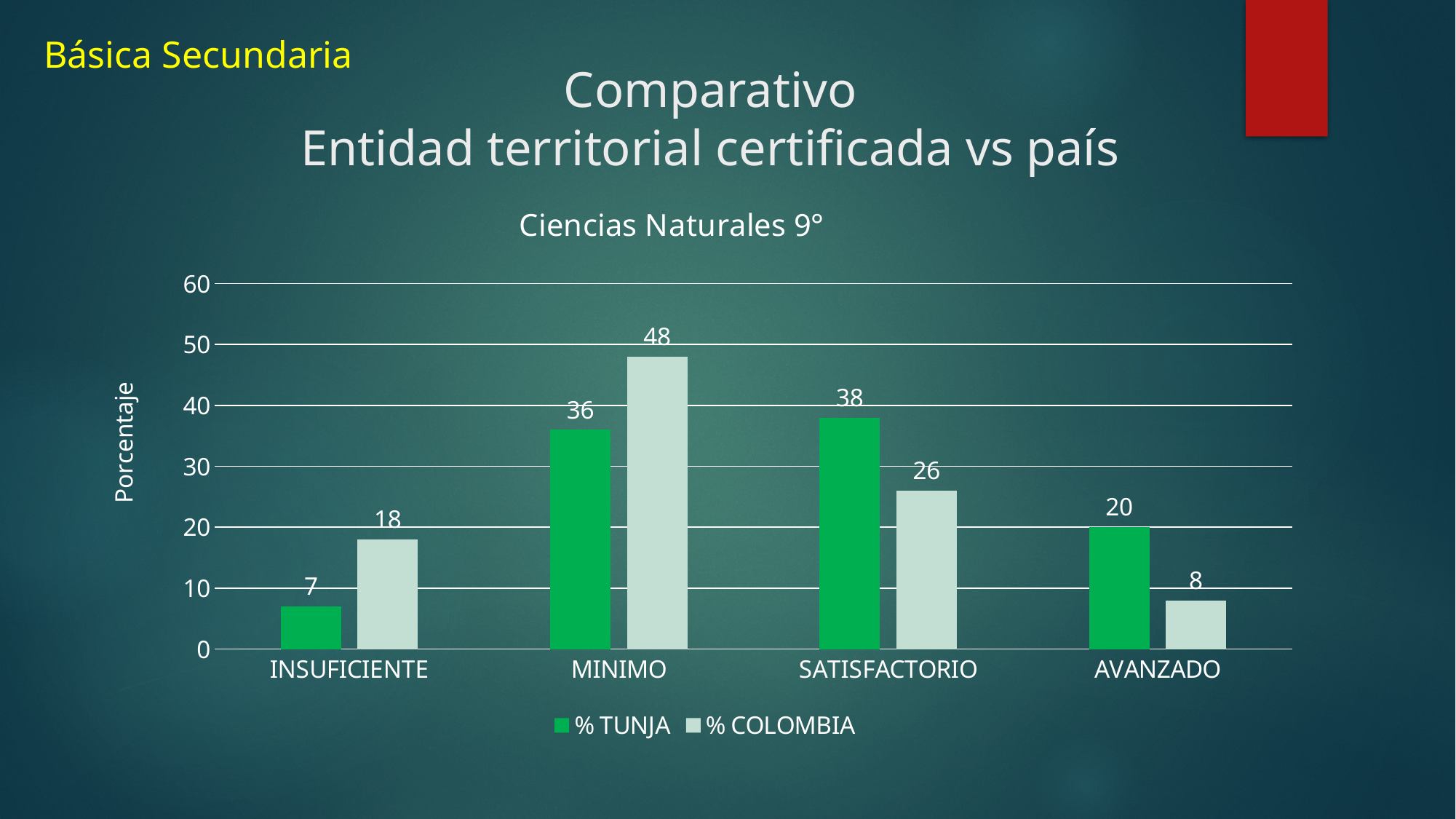
How many series does the legend list? 2 Which is larger for SATISFACTORIO, % TUNJA or % COLOMBIA? % TUNJA How many categories are shown on the x axis? 4 What is the difference between the % COLOMBIA and % TUNJA values for INSUFICIENTE? 11 What kind of chart is shown? bar chart What is the % TUNJA value for MINIMO? 36 Is the % COLOMBIA value for MINIMO greater or less than 40? greater What is the % COLOMBIA value for SATISFACTORIO? 26 Which category has the highest % COLOMBIA value? MINIMO Which category has the lowest % TUNJA value? INSUFICIENTE What is the title of the chart? Ciencias Naturales 9° What is the % TUNJA value for AVANZADO? 20